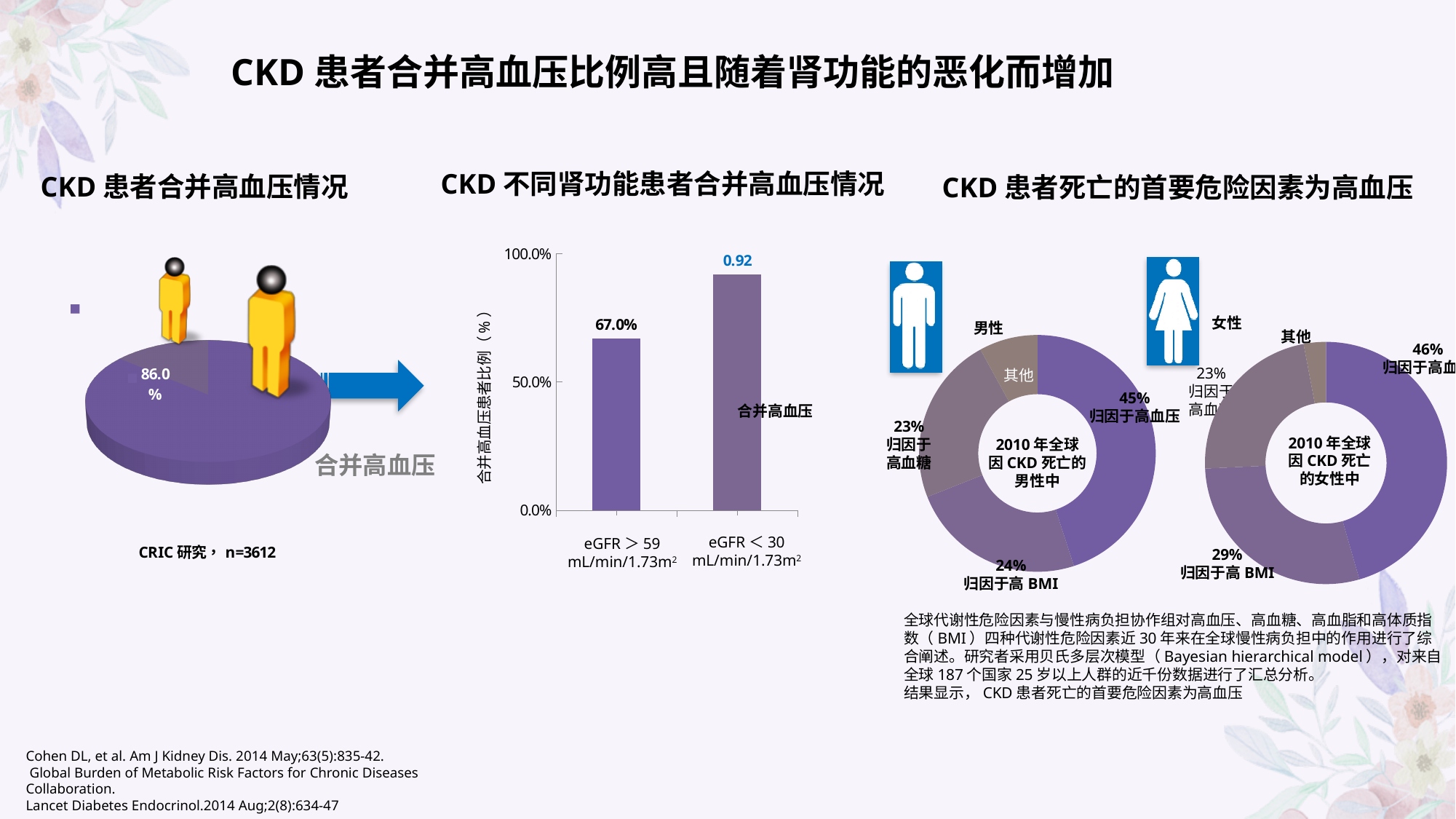
In the pie chart under 'CKD 患者合并高血压情况', what share is labelled for 合并高血压? 86.0% In the bar chart titled 'CKD 不同肾功能患者合并高血压情况', how many bars are plotted? 2 In the men's donut chart (2010 年全球因 CKD 死亡的男性中), what percentage is 归因于高 BMI? 24% In the women's donut chart (2010 年全球因 CKD 死亡的女性中), what percentage is 归因于高血压? 46% In the men's donut chart (2010 年全球因 CKD 死亡的男性中), what percentage is 归因于高血压? 45% Comparing the two donut charts, how many percentage points higher is the 归因于高 BMI share for women (29%) than for men (24%)? 5 What kind of chart is the middle chart titled 'CKD 不同肾功能患者合并高血压情况'? bar chart What kind of chart is shown under 'CKD 患者合并高血压情况' on the left of the slide? pie chart In the bar chart titled 'CKD 不同肾功能患者合并高血压情况', is the value for eGFR > 59 mL/min/1.73m² greater or less than 50.0%? greater In the bar chart titled 'CKD 不同肾功能患者合并高血压情况', what data label is shown on the bar for eGFR < 30 mL/min/1.73m²? 0.92 In the bar chart titled 'CKD 不同肾功能患者合并高血压情况', which eGFR group has the taller bar? eGFR < 30 mL/min/1.73m² In the bar chart titled 'CKD 不同肾功能患者合并高血压情况', what is the value for eGFR > 59 mL/min/1.73m²? 67.0%